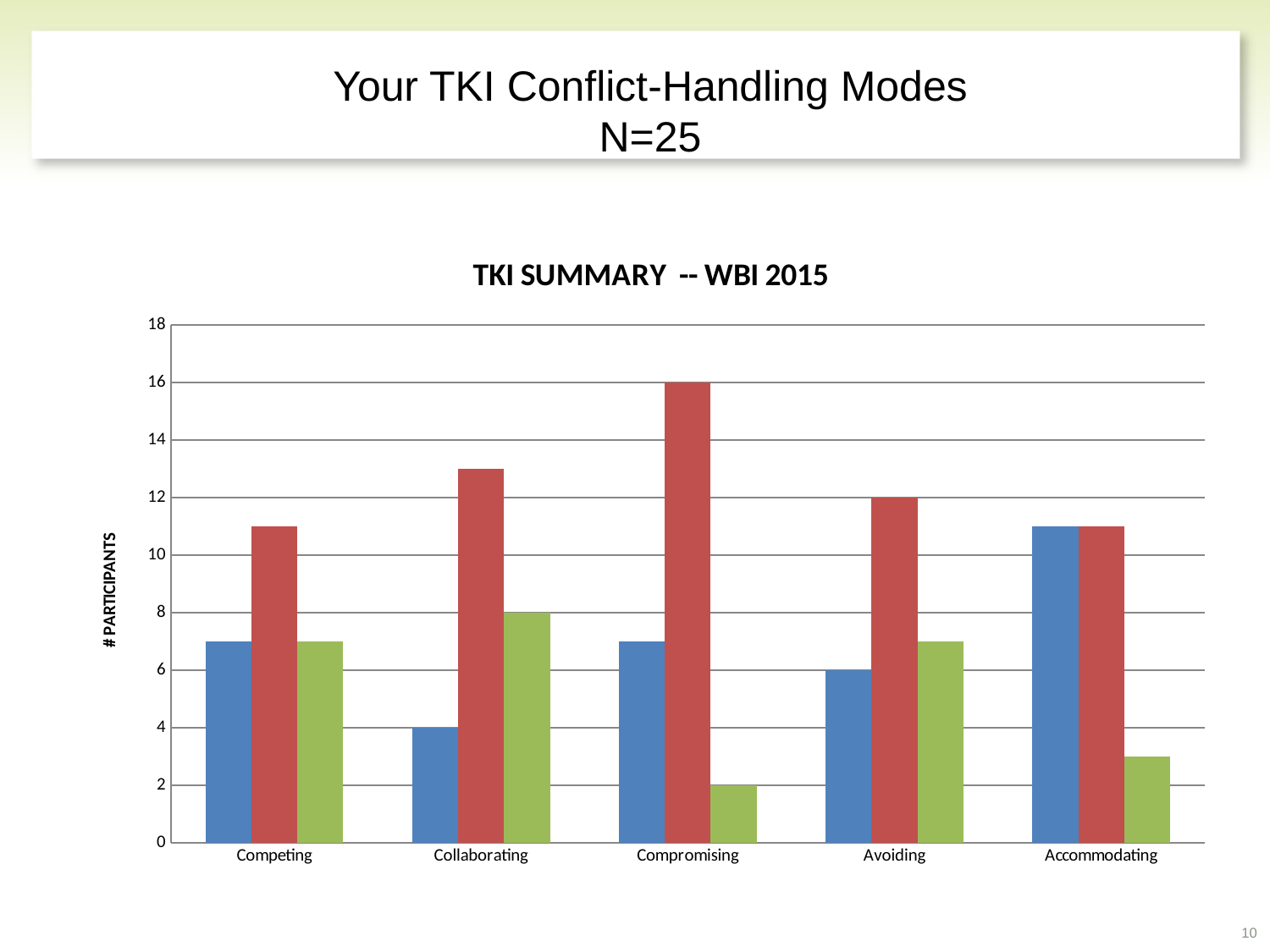
What is the value of the green bar for Compromising? 2 Is the value of the red bar for Collaborating greater or less than 12? greater What type of chart is shown on the slide? bar chart How many conflict-handling mode categories are shown on the x axis? 5 For which category is the red bar the highest? Compromising What is the title of the chart? TKI SUMMARY -- WBI 2015 What is the y-axis label of the chart? # PARTICIPANTS What is the value of the blue bar for Collaborating? 4 Which is larger for Accommodating: the blue bar or the green bar? the blue bar What is the value of the red bar for Avoiding? 12 What is the value of the red bar for Compromising? 16 For which category is the green bar the lowest? Compromising